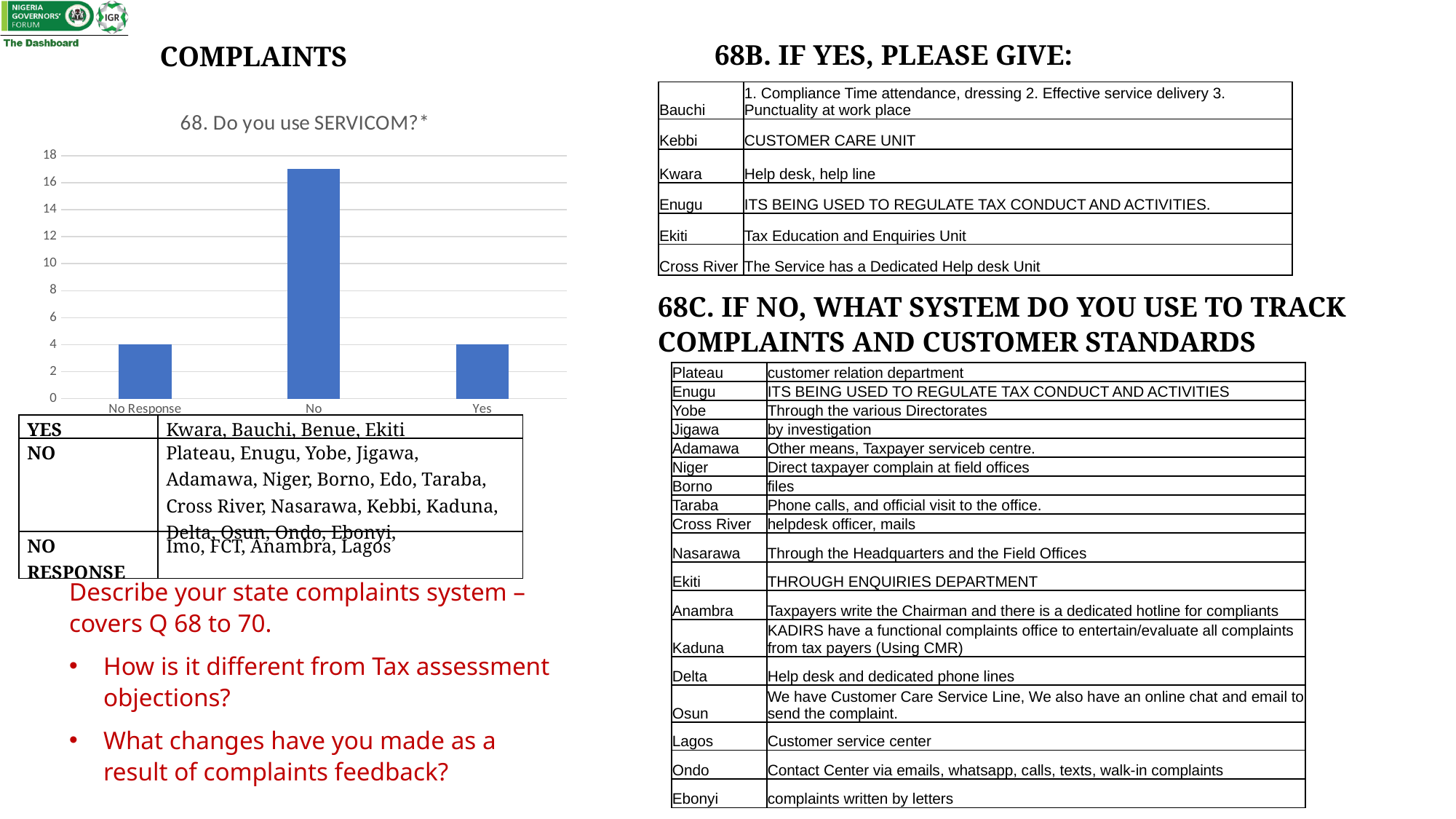
What kind of chart is shown under '68. Do you use SERVICOM?*'? bar chart Is the value for 'No' greater or less than 10? greater Is the value for 'No' greater or less than 16? greater What is the value for 'Yes' in the chart? 4 What is the difference between the values for 'No Response' and 'Yes' in the chart? 0 What is the title of the chart on the slide? 68. Do you use SERVICOM?* Which category has the highest bar in the chart? No Which is larger in the chart, the value for 'No' or the value for 'Yes'? No What colour are the bars in the chart? blue What is the value for 'No Response' in the chart? 4 Is the value for 'Yes' greater or less than 10? less How many categories are shown on the x axis of the chart? 3